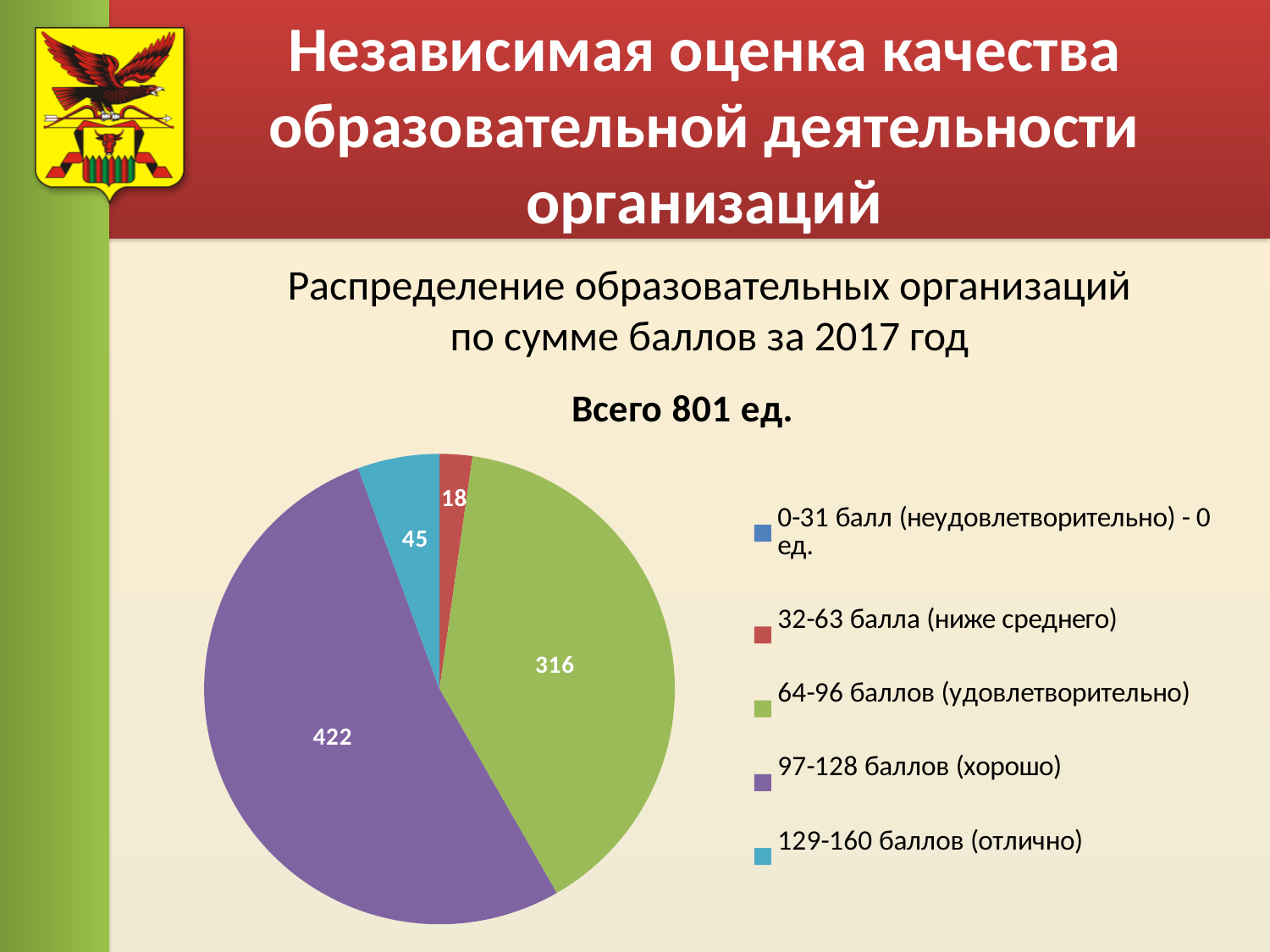
What total is stated in the chart title? Всего 801 ед. How many entries does the legend list? 5 What is the value for the category "129-160 баллов (отлично)"? 45 Which is larger: the value for "129-160 баллов (отлично)" or for "32-63 балла (ниже среднего)"? 129-160 баллов (отлично) Which category with a visible slice has the smallest value? 32-63 балла (ниже среднего) What colour is the slice for "64-96 баллов (удовлетворительно)"? Green Which category has the largest slice of the pie? 97-128 баллов (хорошо) What is the difference between the values for "97-128 баллов (хорошо)" and "64-96 баллов (удовлетворительно)"? 106 What type of chart is shown on the slide? Pie chart What is the value for the category "97-128 баллов (хорошо)"? 422 What is the value for the category "32-63 балла (ниже среднего)"? 18 What is the value for the category "64-96 баллов (удовлетворительно)"? 316